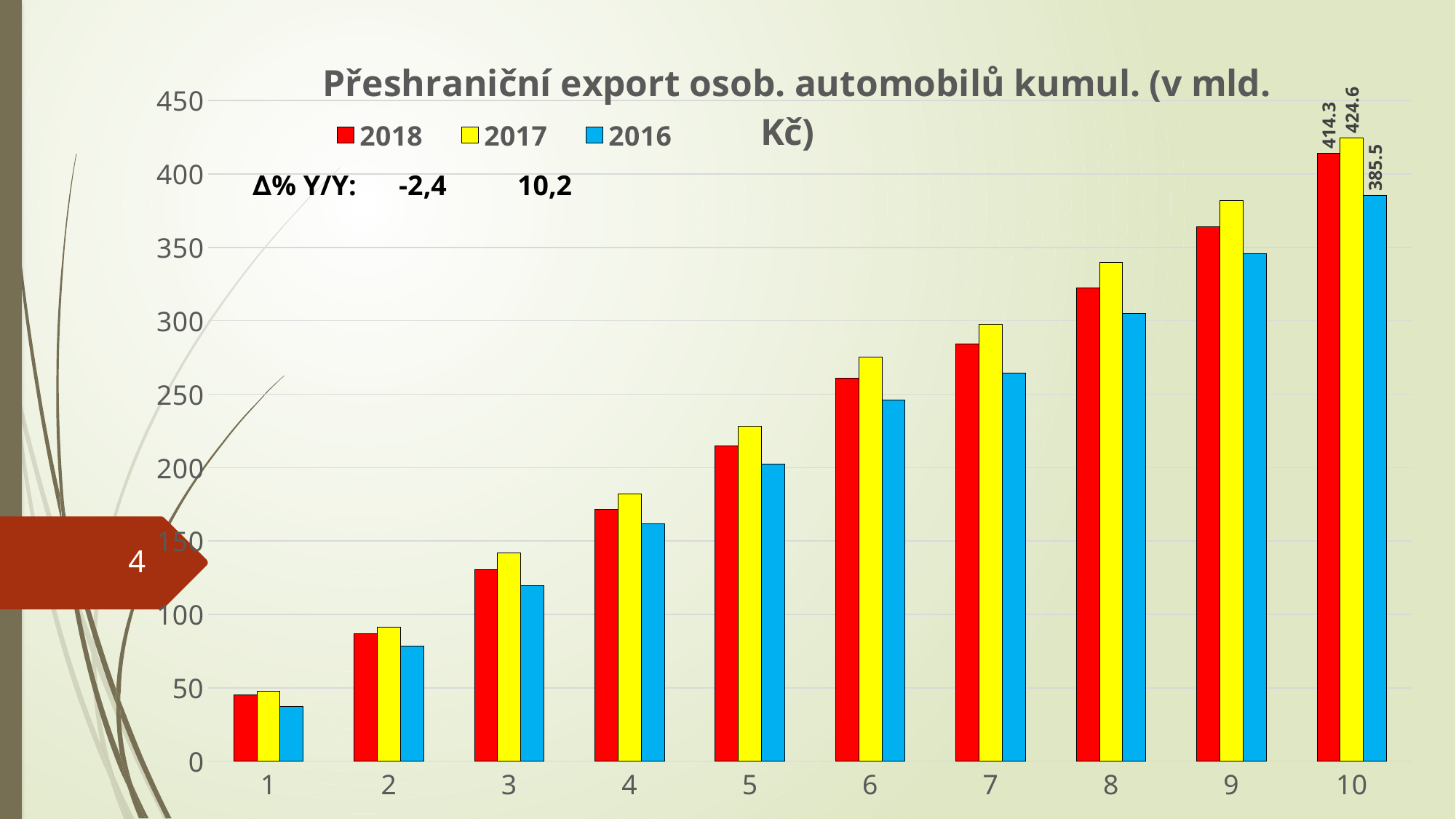
Is the value for 2016 at category 3 greater or less than 150? less At category 10, which series has the highest value? 2017 At category 10, which series has the lowest value? 2016 How many series does the legend list? 3 Is the value for 2018 at category 5 greater or less than 200? greater How many categories are shown on the x axis? 10 What is the difference between the 2018 and 2016 values at category 10? 28.8 Do the values for 2017 rise or fall from category 1 to category 10? rise What is the value for 2017 at category 10? 424.6 What is the value for 2018 at category 10? 414.3 What is the difference between the 2017 and 2018 values at category 10? 10.3 What is the value for 2016 at category 10? 385.5